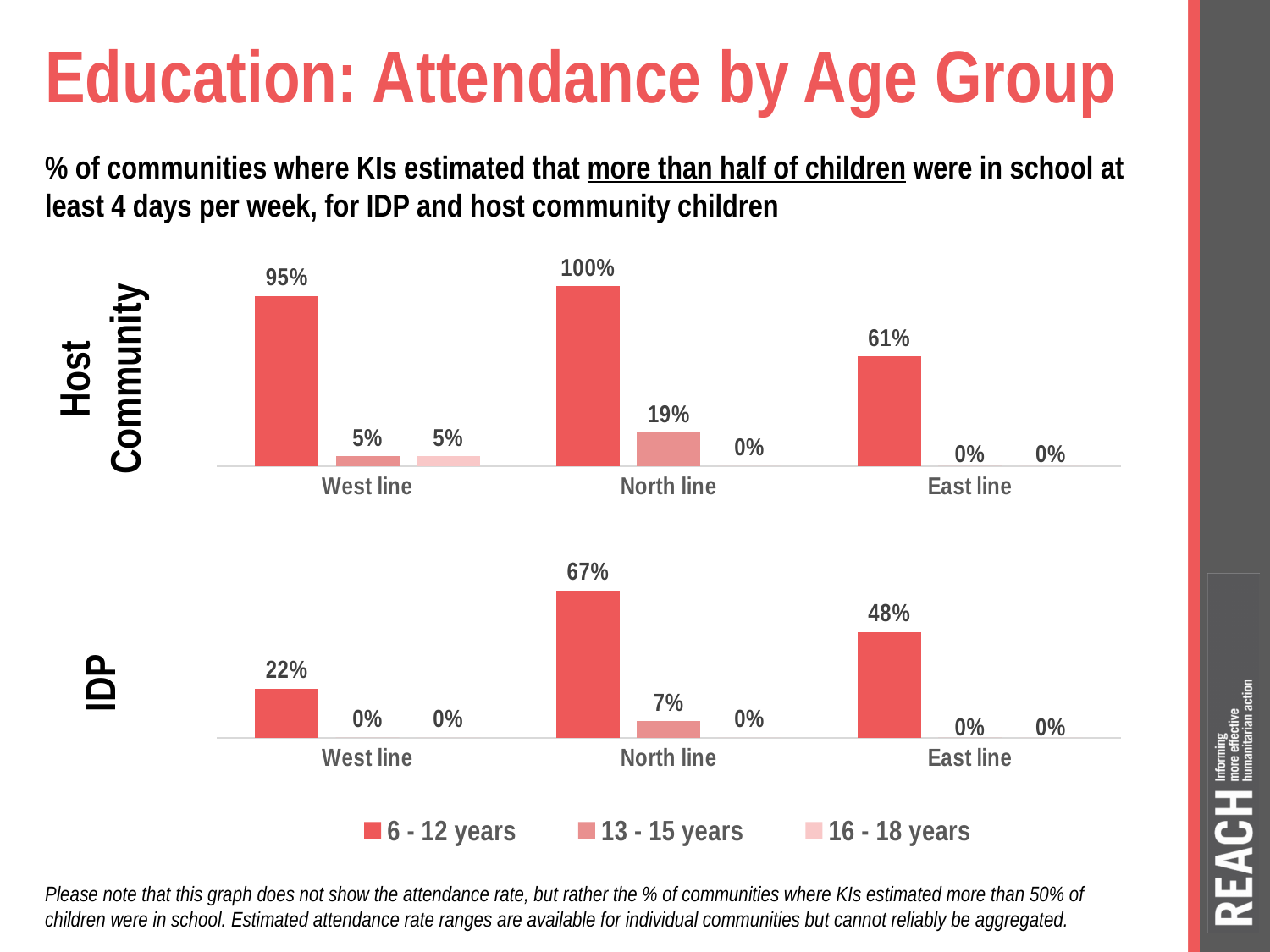
How many series does the legend list? 3 How many lines (categories) are shown on the x axis of the IDP chart? 3 What kind of chart is used for the Host Community data? Bar chart In the IDP chart, what is the value for 13 - 15 years on the North line? 7% What is the difference between the 6 - 12 years value on the East line in the Host Community chart and in the IDP chart? 13% In the IDP chart, what is the value for 6 - 12 years on the West line? 22% In the Host Community chart, which is larger: the 6 - 12 years value on the West line or on the East line? West line In the Host Community chart, what is the value for 6 - 12 years on the North line? 100% In the IDP chart, which line has the lowest value for 6 - 12 years? West line In the Host Community chart, what is the value for 13 - 15 years on the North line? 19% In the Host Community chart, which line has the highest value for 6 - 12 years? North line Which age group does the legend show in the darkest red? 6 - 12 years